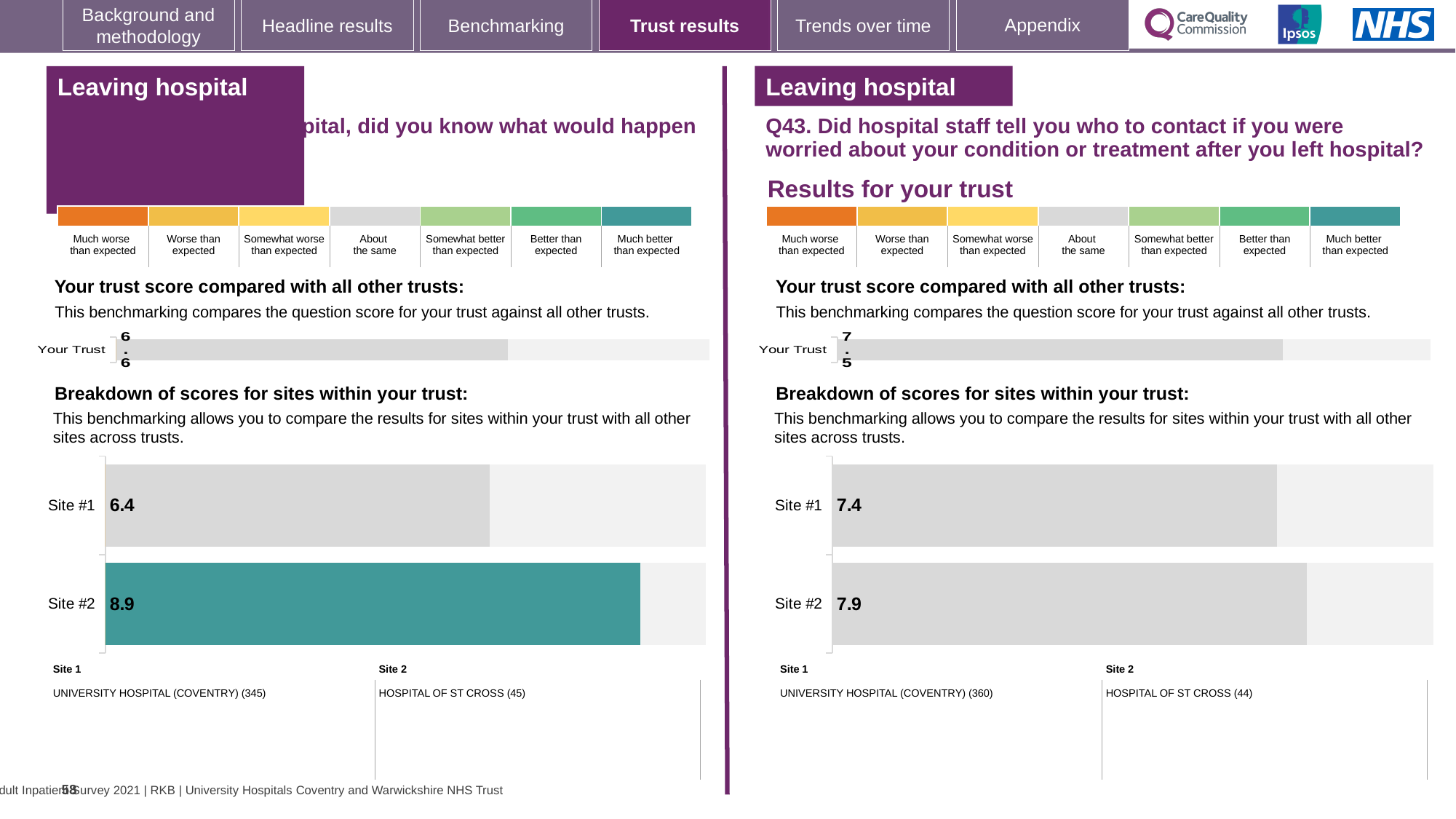
On the right-hand (Q43) 'Your trust score compared with all other trusts' chart, what is the value shown for Your Trust? 7.5 On the left-hand 'Breakdown of scores for sites within your trust' chart, what is the score for Site #1? 6.4 On the right-hand (Q43) site breakdown chart, what is the difference between the Site #2 and Site #1 scores? 0.5 On the right-hand (Q43) 'Breakdown of scores for sites within your trust' chart, what is the score for Site #2? 7.9 On the left-hand site breakdown chart, what is the difference between the Site #2 and Site #1 scores? 2.5 On the left-hand 'Your trust score compared with all other trusts' chart, what is the value shown for Your Trust? 6.6 On the right-hand (Q43) site breakdown chart, which site has the lower score? Site #1 What type of chart is the left-hand 'Breakdown of scores for sites within your trust' chart? Bar chart On the left-hand 'Breakdown of scores for sites within your trust' chart, what is the score for Site #2? 8.9 On the left-hand site breakdown chart, which site has the higher score? Site #2 How many sites are shown on the right-hand (Q43) site breakdown chart? 2 On the right-hand (Q43) 'Breakdown of scores for sites within your trust' chart, what is the score for Site #1? 7.4